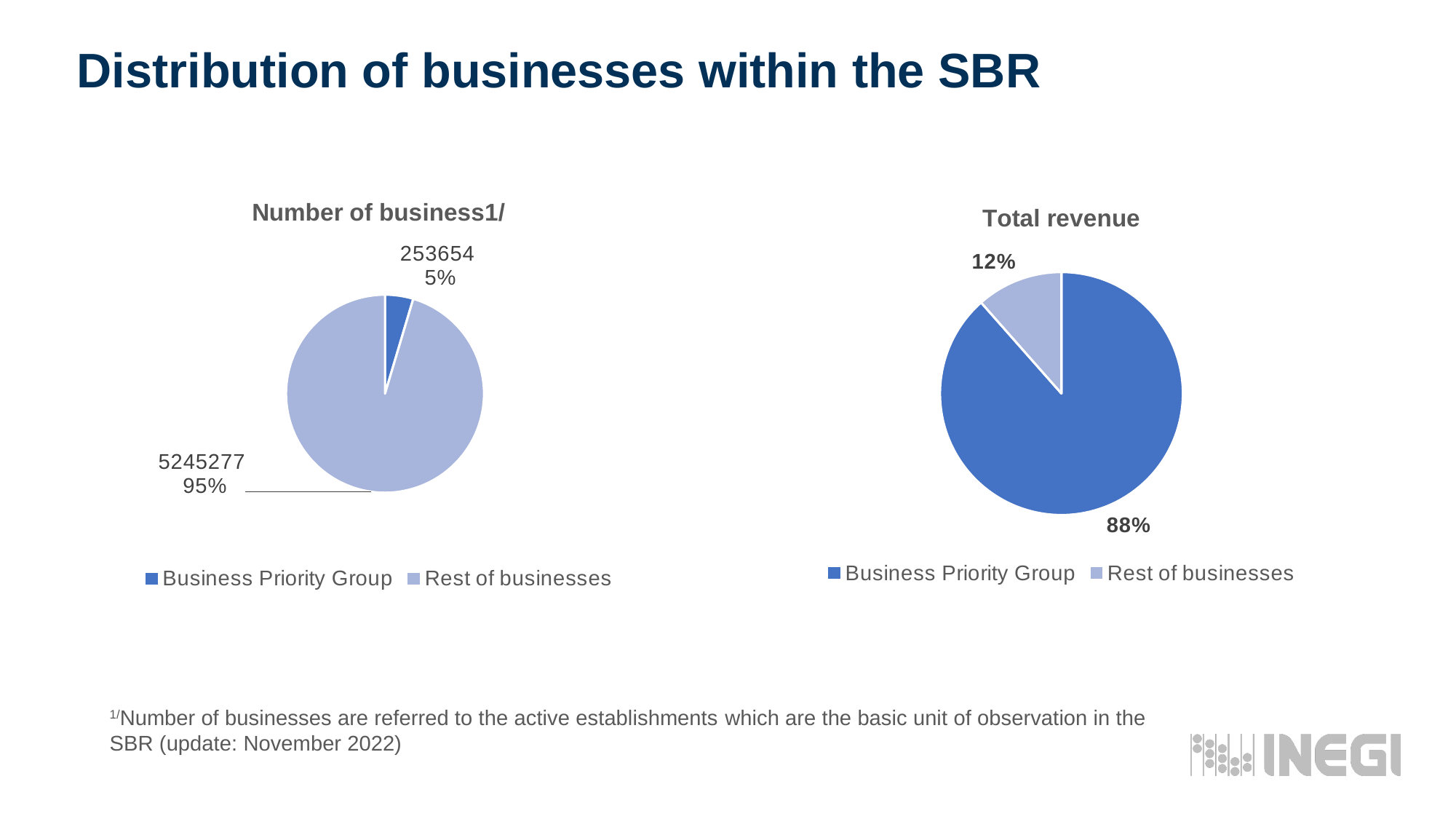
In the 'Total revenue' chart, what share of total revenue does the Rest of businesses slice account for? 12% What type of chart is the 'Total revenue' chart? Pie chart In the 'Number of business' chart, which category has the smallest slice? Business Priority Group In the 'Number of business' chart, what share of businesses does the Business Priority Group represent? 5% How many series does the legend of the 'Total revenue' chart list? 2 In the 'Number of business' chart, what is the difference between the number of businesses in the Rest of businesses slice and the Business Priority Group? 4991623 In the 'Number of business' chart, what is the number of businesses in the Business Priority Group? 253654 In the 'Total revenue' chart, what share of total revenue does the Business Priority Group account for? 88% In the 'Number of business' chart, what is the number of businesses in the Rest of businesses slice? 5245277 In the 'Total revenue' chart, what is the difference in percentage points between the Business Priority Group share and the Rest of businesses share? 76 In the 'Total revenue' chart, which slice is larger: Business Priority Group or Rest of businesses? Business Priority Group